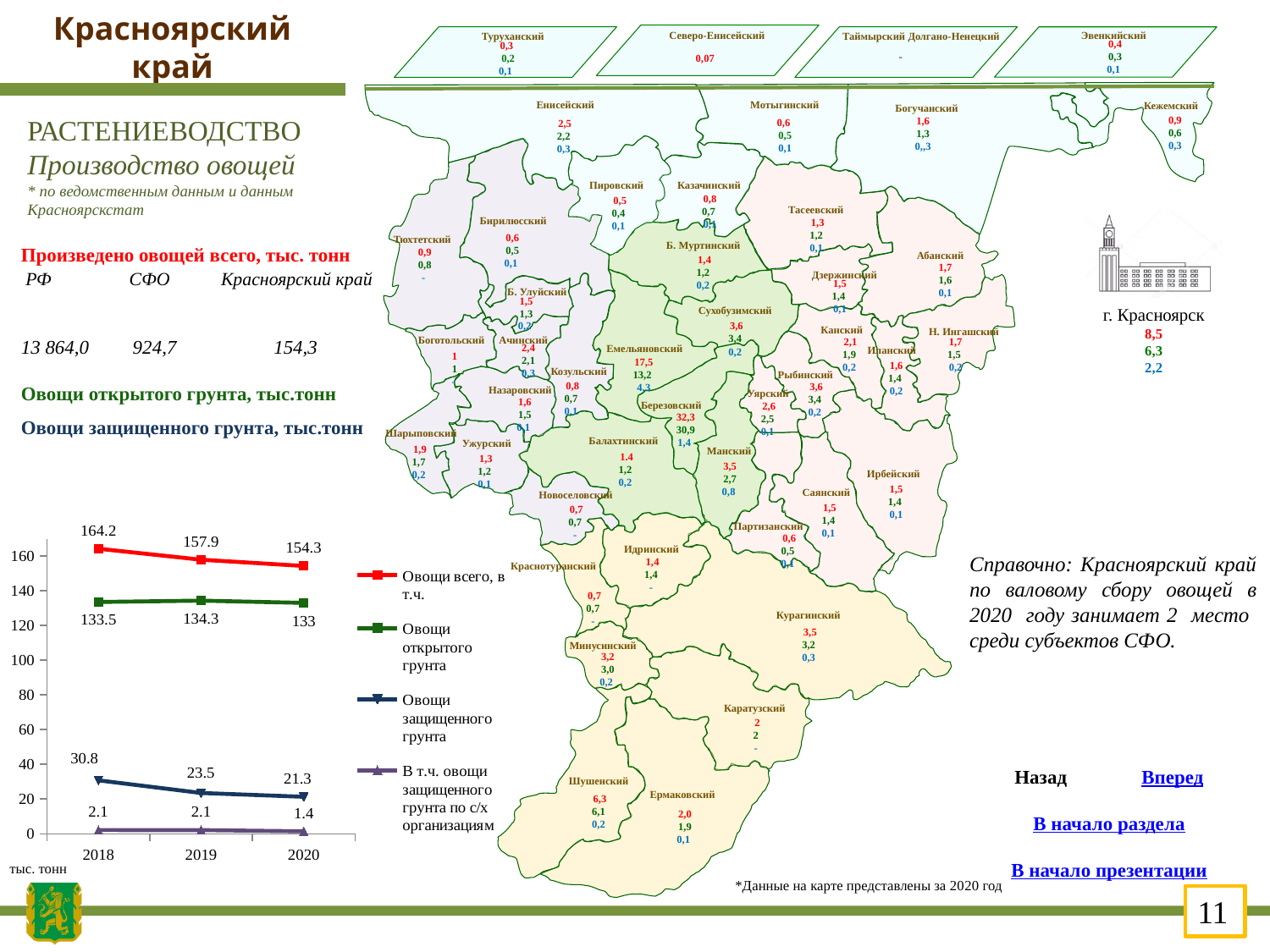
In the line chart, what is the value for "Овощи защищенного грунта" in 2020? 21.3 In the line chart, in which year is the value for "Овощи защищенного грунта" lowest? 2020 In the line chart, does the value for "Овощи всего, в т.ч." rise or fall from 2018 to 2020? fall In the line chart, what is the value for "В т.ч. овощи защищенного грунта по с/х организациям" in 2020? 1.4 How many series does the legend of the line chart list? 4 In the line chart, what is the value for "Овощи открытого грунта" in 2019? 134.3 How many years are plotted on the x axis of the line chart? 3 In the line chart, what is the difference between the "Овощи всего, в т.ч." values for 2018 and 2020? 9.9 In the line chart, which is larger: "Овощи защищенного грунта" in 2018 or in 2019? 2018 In the line chart, what is the value for "Овощи всего, в т.ч." in 2018? 164.2 What type of chart is shown at the bottom left of the slide? line chart In the line chart, in which year is the value for "Овощи всего, в т.ч." highest? 2018